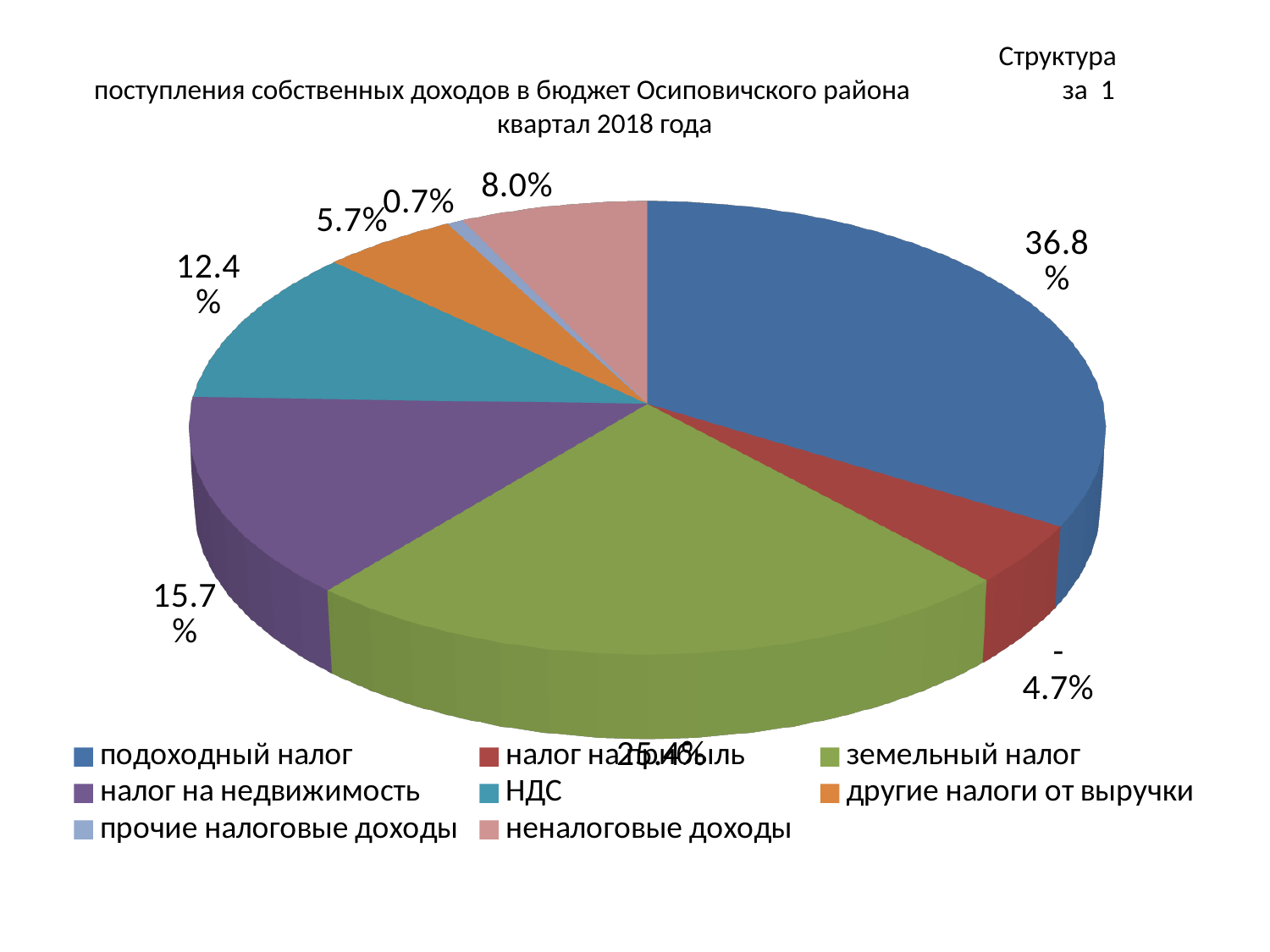
How many slices does the pie chart have? 8 What colour is the slice for земельный налог? green By how many percentage points does подоходный налог exceed налог на недвижимость? 21.1 Which category has the largest share of the pie? подоходный налог What share of the pie is неналоговые доходы? 8.0% What share of the pie is налог на прибыль? -4.7% What share of the pie is НДС? 12.4% What share of the pie is прочие налоговые доходы? 0.7% What kind of chart is shown on the slide? pie chart What share of the pie is подоходный налог? 36.8% Which has the larger share: НДС or другие налоги от выручки? НДС